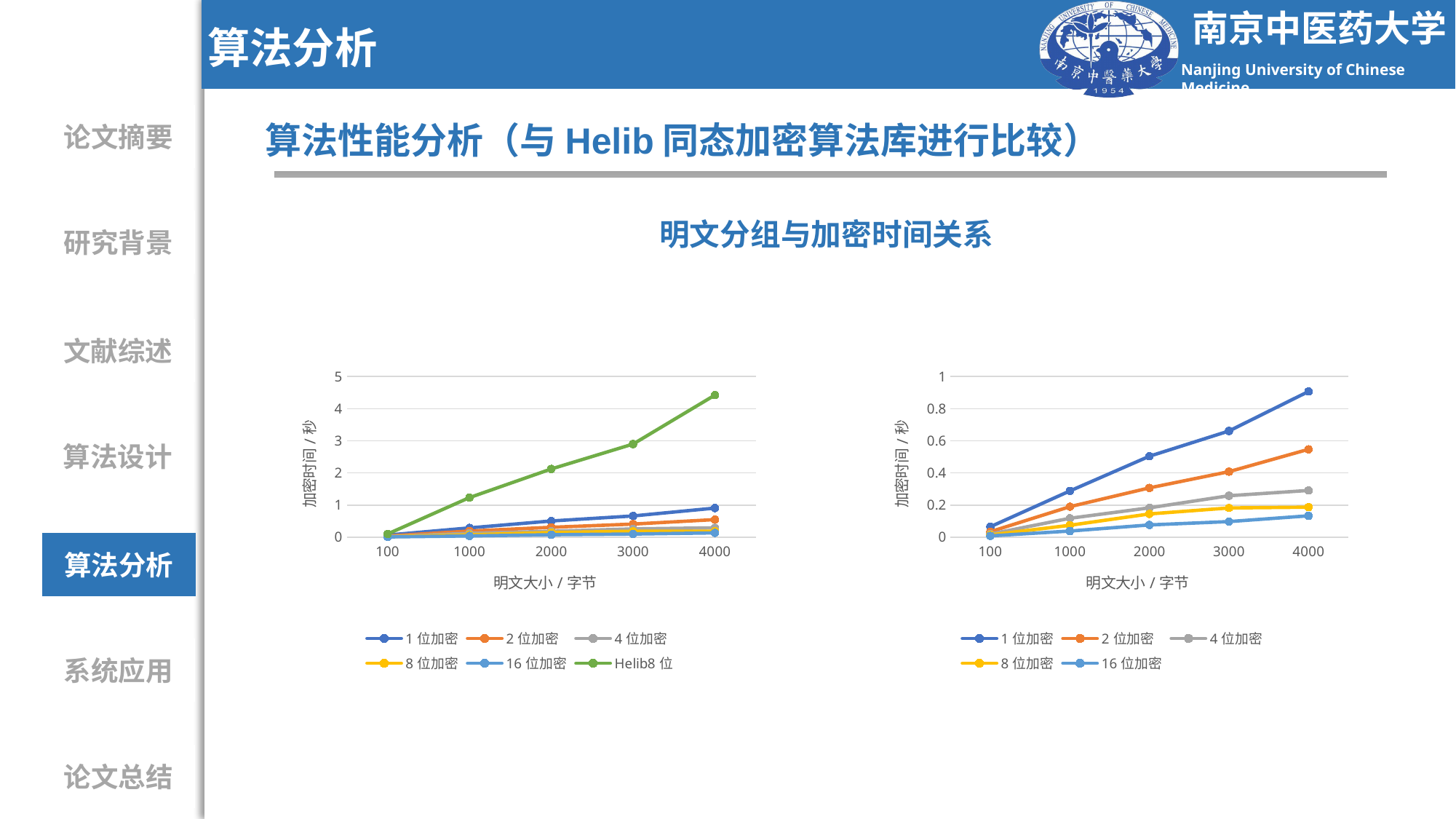
What kind of chart is the left chart on the slide? line chart In the left chart, is the value of Helib8 位 at 明文大小 4000 greater or less than 4? greater What is the title shown above the two charts? 明文分组与加密时间关系 How many x-axis categories (明文大小 values) are plotted in the right chart? 5 How many series does the legend of the left chart list? 6 In the right chart, which series has the lowest value at 明文大小 4000? 16 位加密 In the right chart, is the value of 1 位加密 at 明文大小 4000 greater or less than 0.8? greater How many series does the legend of the right chart list? 5 In the right chart, at 明文大小 3000, which is larger: 1 位加密 or 4 位加密? 1 位加密 In the left chart, which series has the highest value at 明文大小 4000? Helib8 位 In the right chart, is the value of 2 位加密 at 明文大小 2000 greater or less than 0.4? less In the left chart, does the Helib8 位 series rise or fall as 明文大小 increases from 100 to 4000? rise